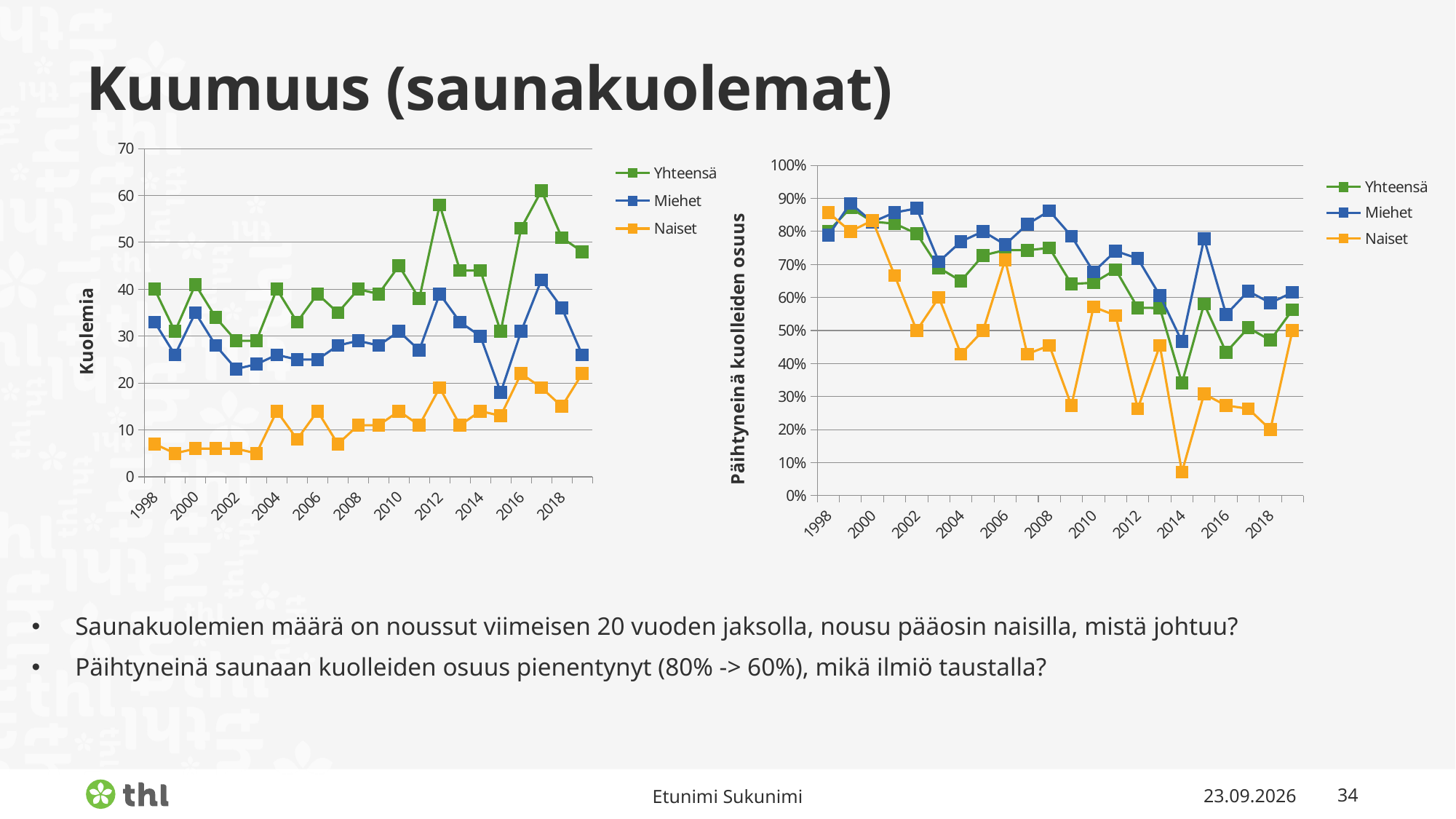
In the right chart (Päihtyneinä kuolleiden osuus), is the value for Naiset in 2014 greater or less than 10%? less In the left chart (Kuolemia), is the value for Miehet in 2015 greater or less than 30? less In the right chart (Päihtyneinä kuolleiden osuus), is the value for Miehet in 1999 greater or less than 80%? greater In the right chart (Päihtyneinä kuolleiden osuus), does the Yhteensä series generally rise or fall from 1998 to 2019? fall In the left chart (Kuolemia), which year has the highest value for Yhteensä? 2017 What kind of chart is the left chart (Kuolemia)? line chart How many series does the legend of the right chart (Päihtyneinä kuolleiden osuus) list? 3 In the right chart (Päihtyneinä kuolleiden osuus), which year has the lowest value for Naiset? 2014 In the left chart (Kuolemia), which series is higher in 2017, Yhteensä or Naiset? Yhteensä What is the y-axis title of the left chart? Kuolemia